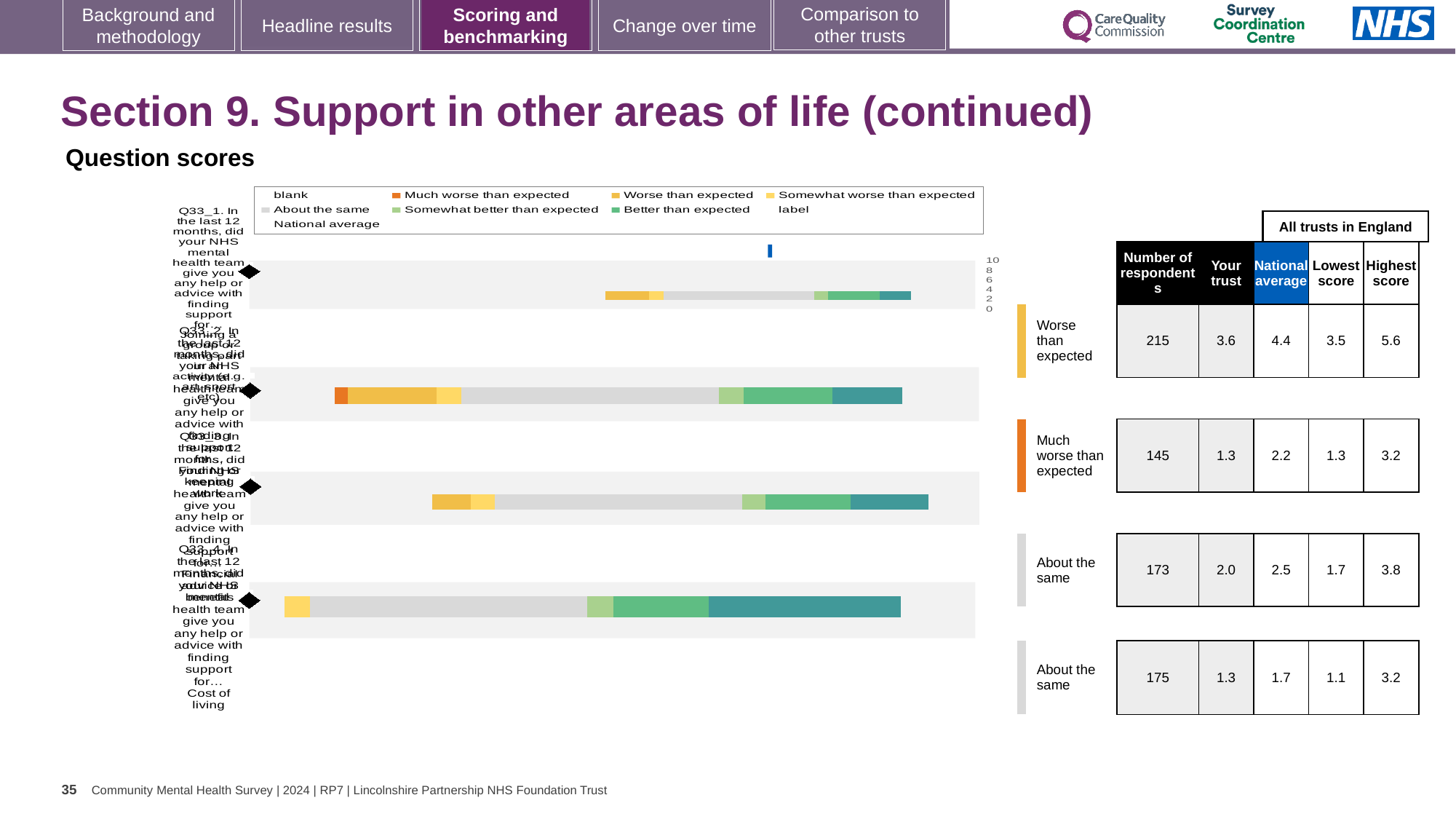
Which row has the highest number of respondents in the table? The first row (Q33_1), 215 Which row has the lowest national average in the table? The fourth row, 1.7 In the table, what is the number of respondents for the first row (Q33_1)? 215 In the table, what is the lowest score for the third row? 1.7 In the table, what is the national average for the first row (Q33_1)? 4.4 How many question bars are plotted in the chart? 4 In the table, what is the 'Your trust' score for the first row (Q33_1)? 3.6 For the third row, which is larger: the 'Your trust' score or the national average? National average How many entries does the chart legend list? 9 What kind of chart is shown under 'Question scores'? bar chart For the first row (Q33_1), what is the difference between the national average and the 'Your trust' score? 0.8 What benchmark label is shown next to the first bar (Q33_1)? Worse than expected